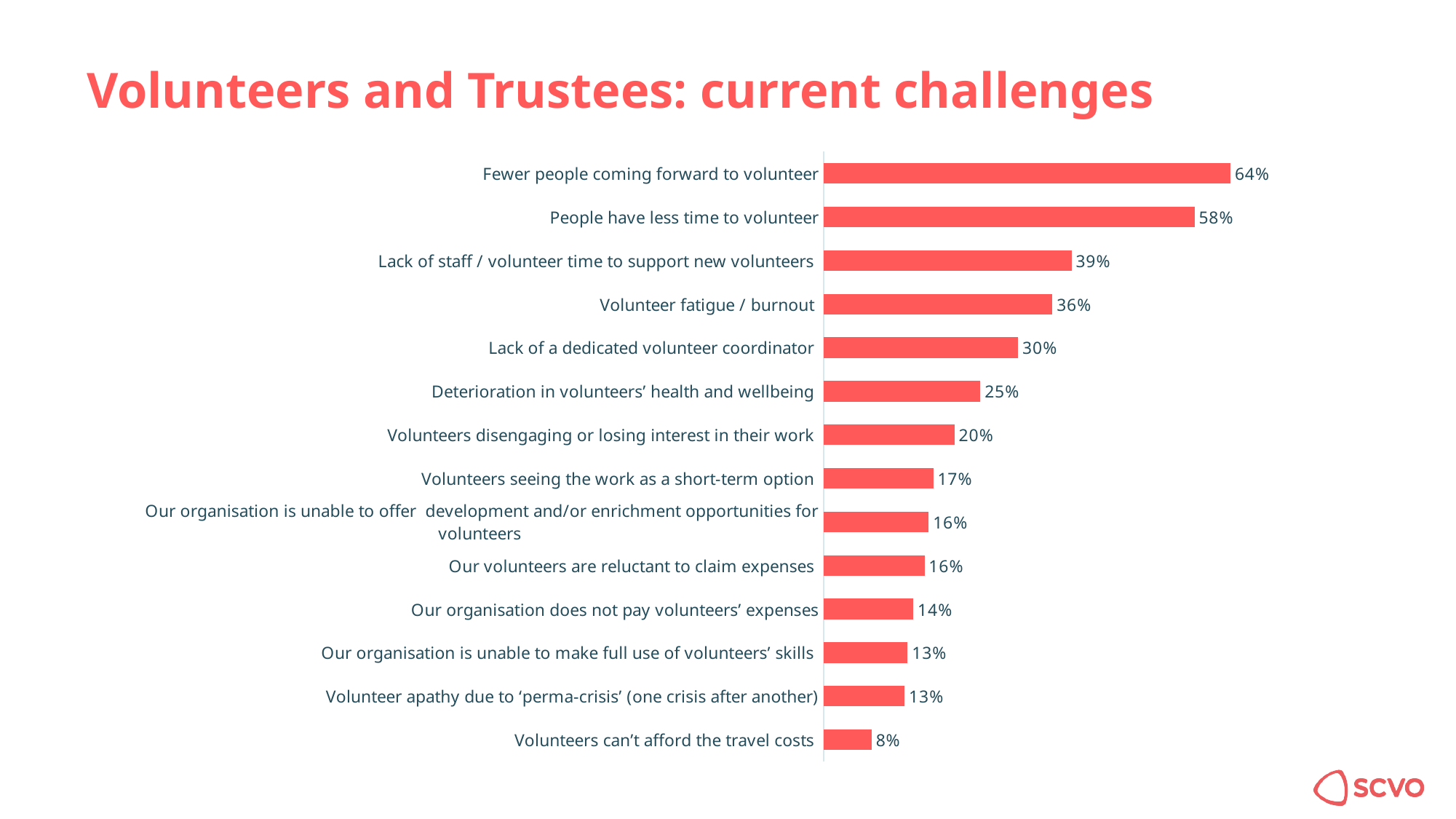
Which is larger: 'Deterioration in volunteers' health and wellbeing' or 'Volunteers disengaging or losing interest in their work'? Deterioration in volunteers' health and wellbeing Which challenge has the highest percentage? Fewer people coming forward to volunteer What kind of chart is shown on the slide? Bar chart How many challenges are listed in the chart? 14 What percentage is shown for 'Lack of a dedicated volunteer coordinator'? 30% What is the value for 'Volunteers can't afford the travel costs'? 8% What is the difference between 'Lack of staff / volunteer time to support new volunteers' and 'Volunteer fatigue / burnout'? 3% What is the difference between 'Fewer people coming forward to volunteer' and 'People have less time to volunteer'? 6% What is the value for 'Volunteer fatigue / burnout'? 36% What percentage is shown for 'Fewer people coming forward to volunteer'? 64% What is the title of the slide? Volunteers and Trustees: current challenges Which challenge has the lowest percentage? Volunteers can't afford the travel costs